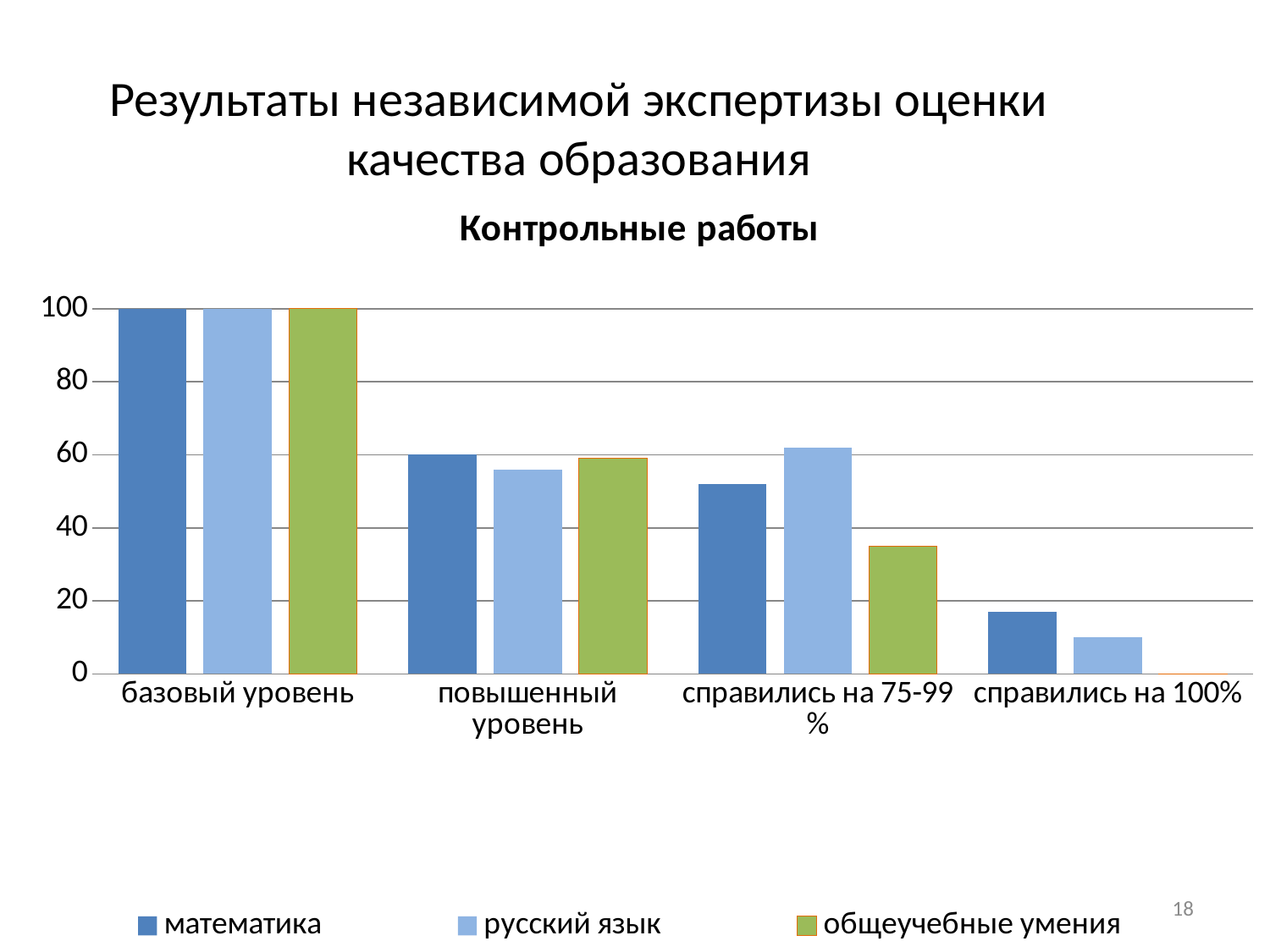
What is the value for математика in the базовый уровень category? 100 How many series does the legend list? 3 How many categories are shown on the x axis? 4 Is the value for математика in the справились на 100% category greater or less than 20? less In the справились на 100% category, which is larger: математика or русский язык? математика Is the value for общеучебные умения in the справились на 75-99 % category greater or less than 40? less For the общеучебные умения series, which category has the lowest value? справились на 100% In the справились на 75-99 % category, which is larger: русский язык or общеучебные умения? русский язык What is the value for общеучебные умения in the базовый уровень category? 100 What kind of chart is shown on the slide? bar chart Do the values for математика rise or fall from left to right along the x axis? fall Is the value for русский язык in the справились на 75-99 % category greater or less than 40? greater